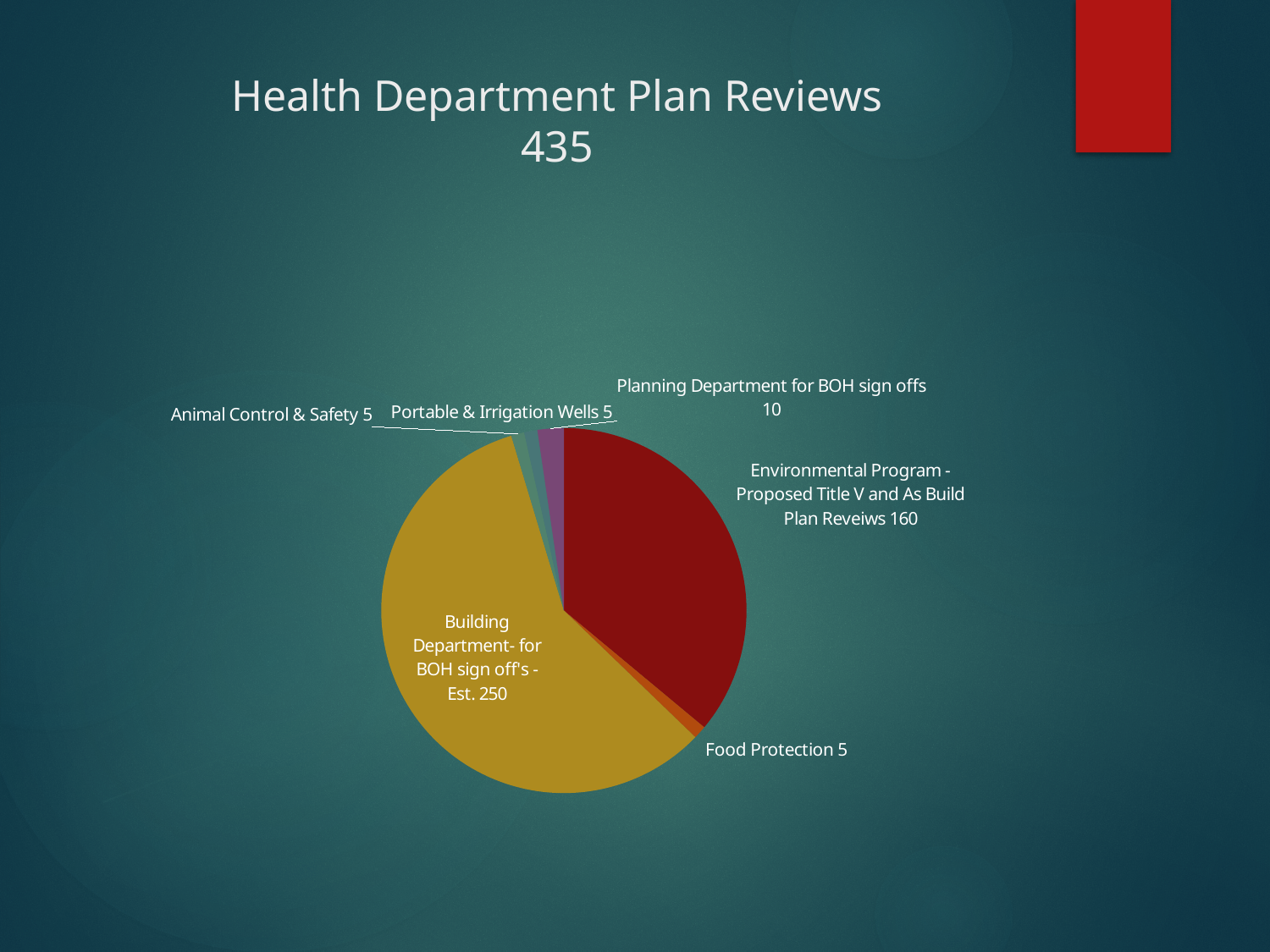
What is the value for Building Department- for BOH sign off's? Est. 250 What kind of chart is shown on the slide? Pie chart Which category has the largest slice of the pie? Building Department- for BOH sign off's - Est. 250 What is the value for Environmental Program - Proposed Title V and As Build Plan Reveiws? 160 How many slices does the pie chart have? 6 What is the value for Animal Control & Safety? 5 What is the title of the chart on the slide? Health Department Plan Reviews 435 What is the total of all the slice values in the pie chart? 435 What is the value for Food Protection? 5 What is the difference between the Building Department value and the Environmental Program value? 90 Which is larger, Environmental Program - Proposed Title V and As Build Plan Reveiws or Planning Department for BOH sign offs? Environmental Program - Proposed Title V and As Build Plan Reveiws What is the value for Planning Department for BOH sign offs? 10